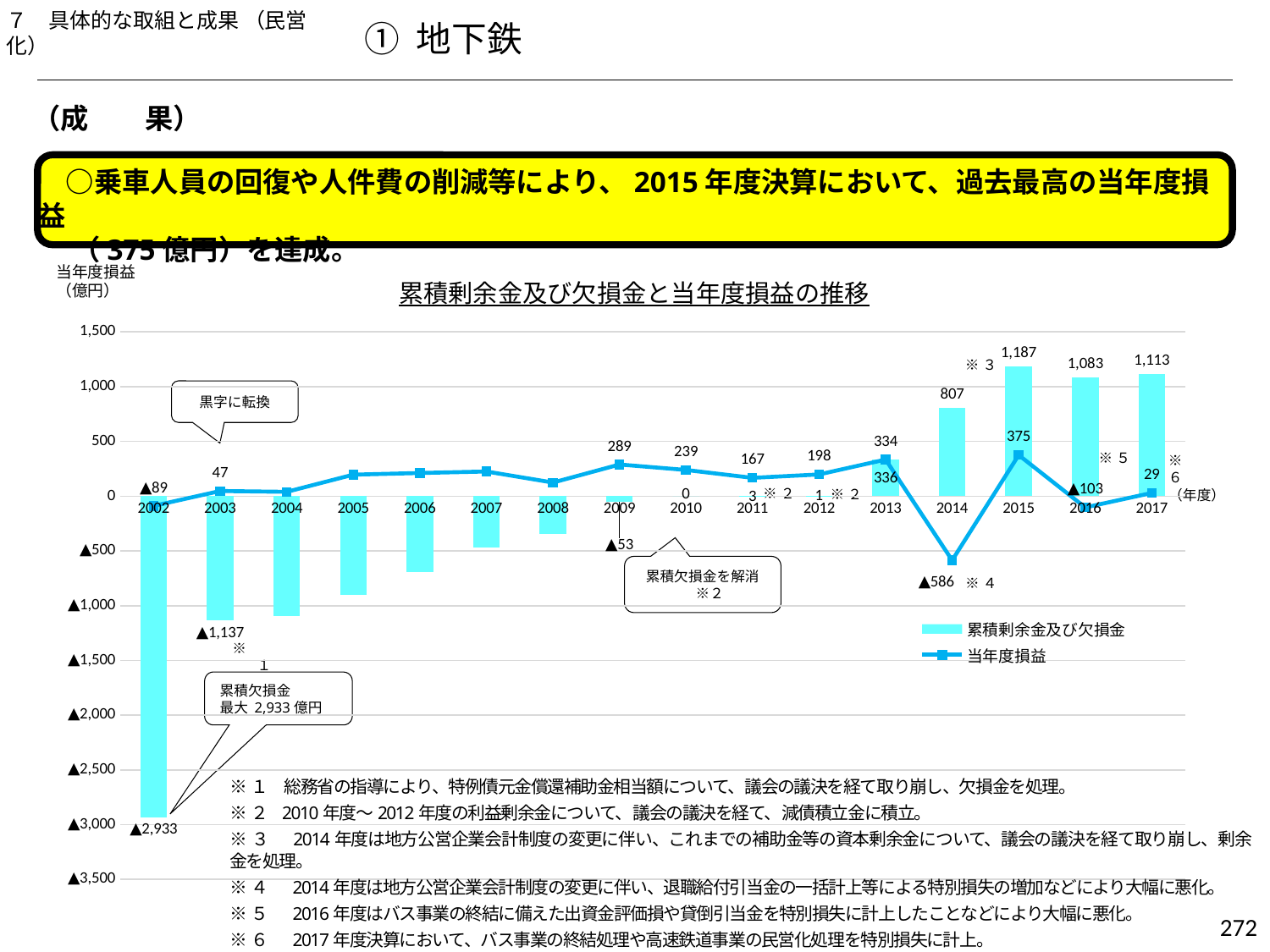
What is the difference between the 当年度損益 values for 2015 and 2013? 41 In which year is the 当年度損益 line at its lowest point? 2014 How many series does the chart legend list? 2 What is the 累積剰余金及び欠損金 value for 2014? 807 What kind of chart is shown on the slide? Combined bar and line chart What is the 当年度損益 value for 2015? 375 In which year is the 累積剰余金及び欠損金 bar highest? 2015 Which year has the larger 当年度損益 value, 2010 or 2013? 2013 How many years are shown on the x axis of the chart? 16 What is the 累積剰余金及び欠損金 value for 2002? ▲2,933 Is the 当年度損益 value for 2006 greater or less than 500? less What is the difference between the 累積剰余金及び欠損金 values for 2015 and 2016? 104